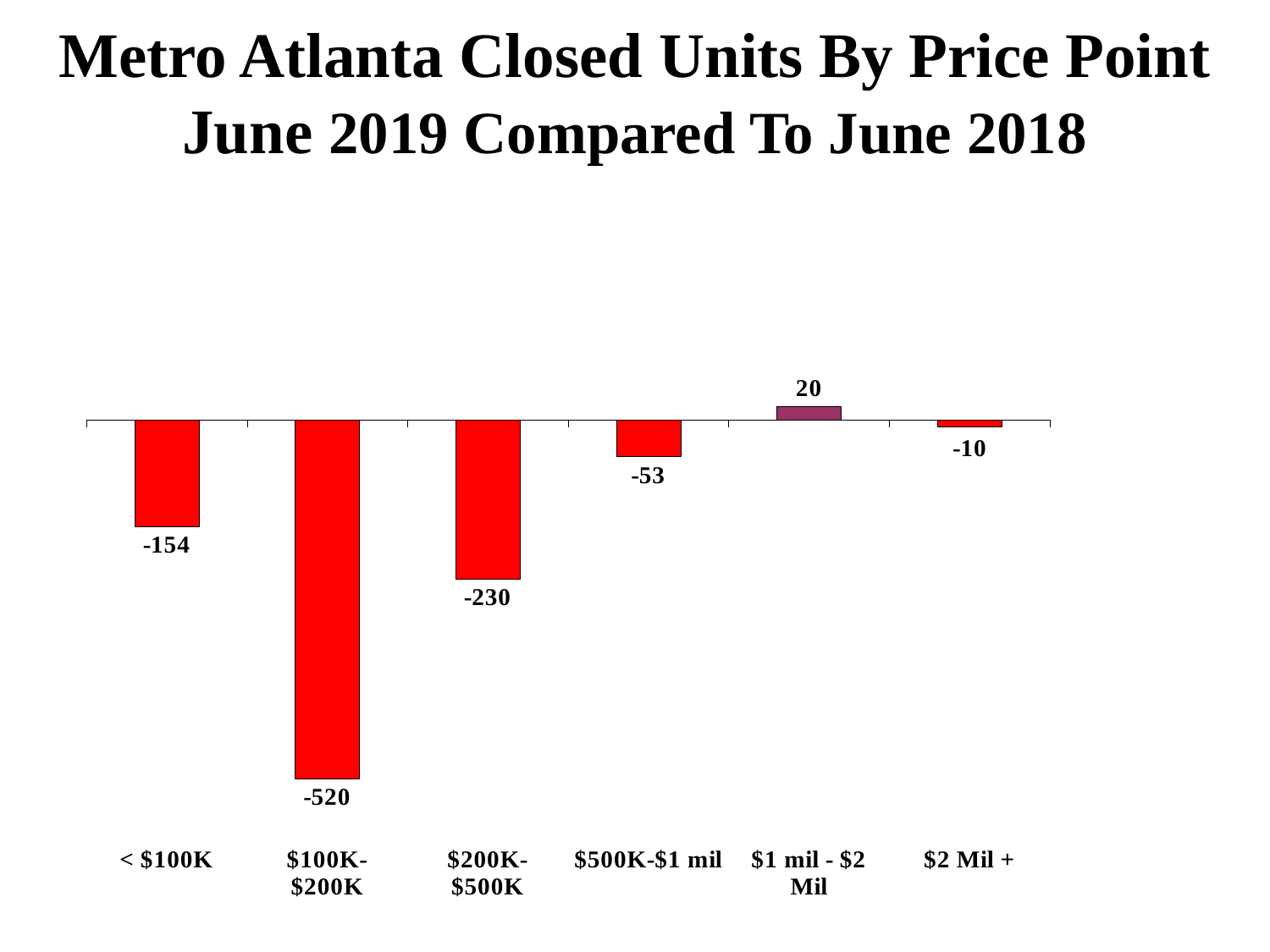
What is the difference between the values for $200K-$500K and $500K-$1 mil? 177 How many price points have a positive value? 1 Which is larger, the value for < $100K or the value for $200K-$500K? < $100K What kind of chart is shown on the slide? Bar chart What is the value for the $100K-$200K price point? -520 Which price point has the highest value? $1 mil - $2 Mil What is the value for the $2 Mil + price point? -10 How many price point categories are shown in the chart? 6 Which price point has the lowest value? $100K-$200K What is the title of the chart? Metro Atlanta Closed Units By Price Point June 2019 Compared To June 2018 What is the value for the $1 mil - $2 Mil price point? 20 What is the value for the < $100K price point? -154